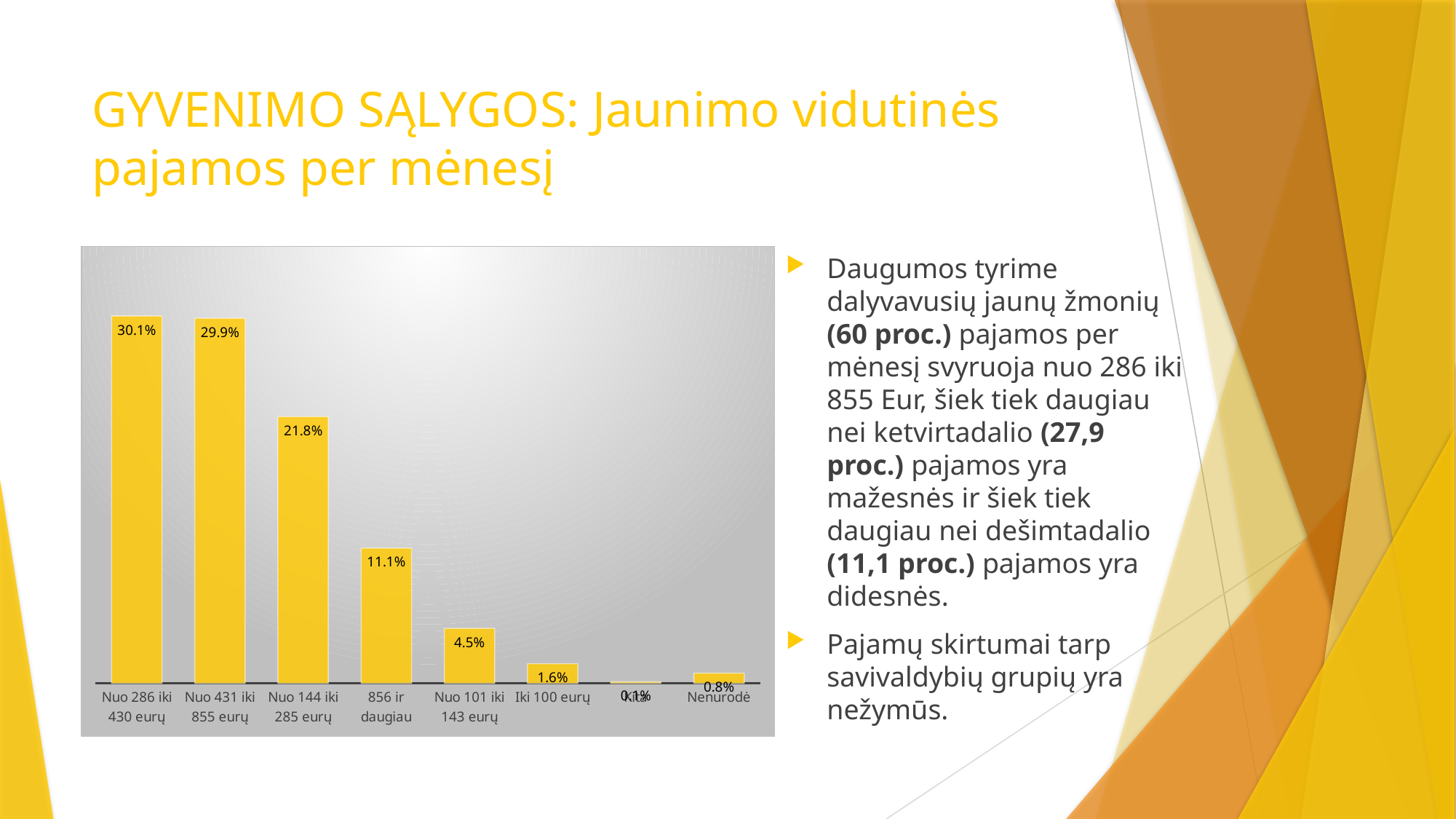
What is the difference between the values for "Nuo 144 iki 285 eurų" and "856 ir daugiau"? 10.7% What is the value for the category "Nuo 144 iki 285 eurų"? 21.8% What is the value for the category "Iki 100 eurų"? 1.6% Which category has the highest value? Nuo 286 iki 430 eurų What is the difference between the values for "Nuo 286 iki 430 eurų" and "Nuo 431 iki 855 eurų"? 0.2% What is the value for the category "856 ir daugiau"? 11.1% What kind of chart is shown on the slide? Bar chart How many categories are shown in the chart? 8 What is the value for the category "Nenurodė"? 0.8% What is the value for the category "Nuo 286 iki 430 eurų"? 30.1% Which is larger, the value for "Nuo 101 iki 143 eurų" or the value for "Iki 100 eurų"? Nuo 101 iki 143 eurų Which category has the lowest value? Kita